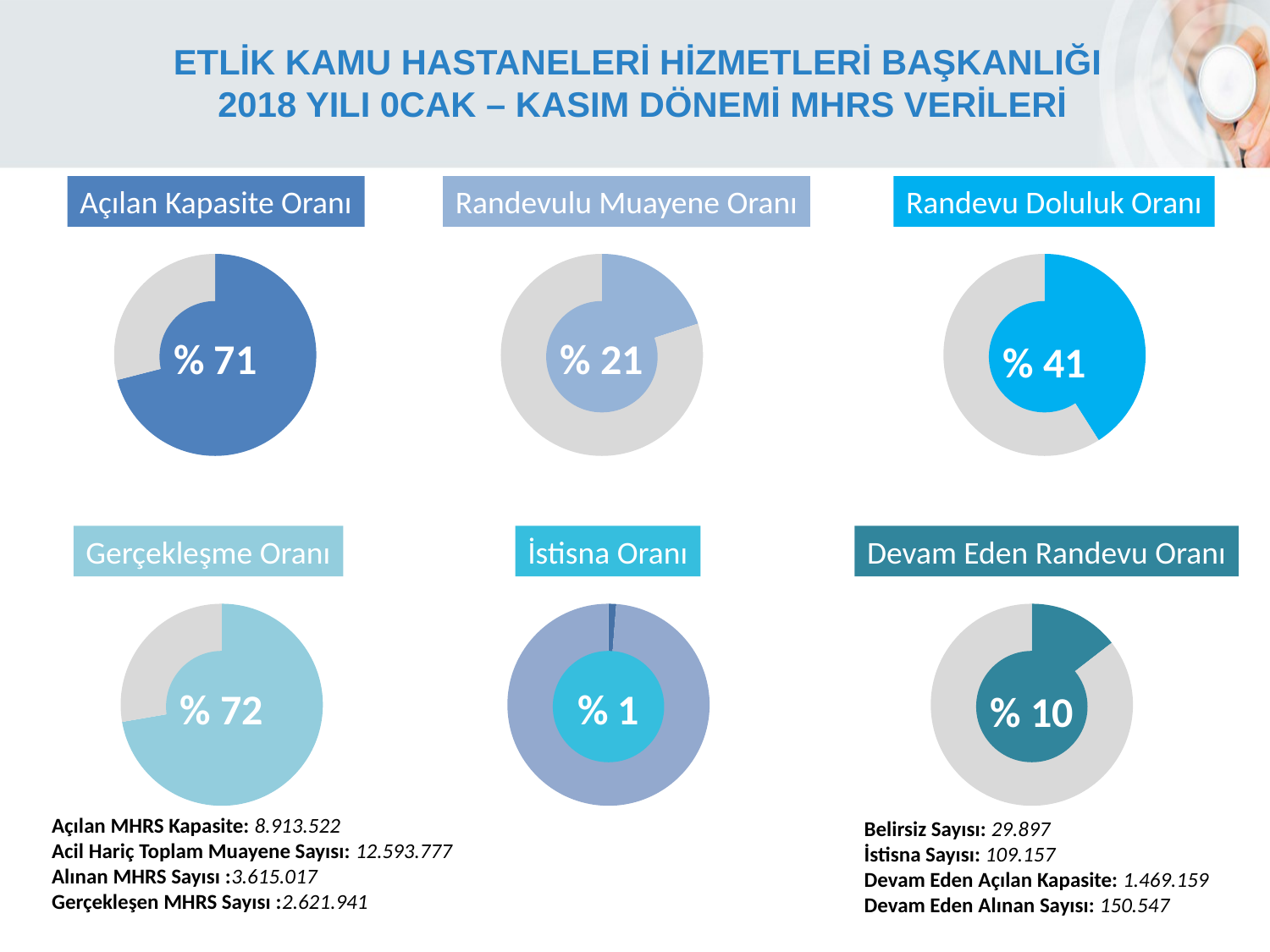
How many doughnut charts are shown on the slide? 6 In the 'Devam Eden Randevu Oranı' chart, what value is shown in the centre? % 10 In the 'Gerçekleşme Oranı' chart, what value is shown in the centre? % 72 In the 'Randevulu Muayene Oranı' chart, what value is printed in the centre? % 21 Which of the six charts shows the lowest percentage? İstisna Oranı Which chart shows the higher value, 'Gerçekleşme Oranı' or 'Açılan Kapasite Oranı'? Gerçekleşme Oranı What kind of chart is used for 'Açılan Kapasite Oranı'? Doughnut chart In the 'Randevu Doluluk Oranı' chart, what percentage is displayed? % 41 In the 'İstisna Oranı' chart, what percentage is printed? % 1 What is the difference between the value in the 'Randevu Doluluk Oranı' chart and the value in the 'Randevulu Muayene Oranı' chart? 20 In the 'Açılan Kapasite Oranı' chart, what percentage is shown in the centre of the doughnut? % 71 Which of the six charts shows the highest percentage? Gerçekleşme Oranı